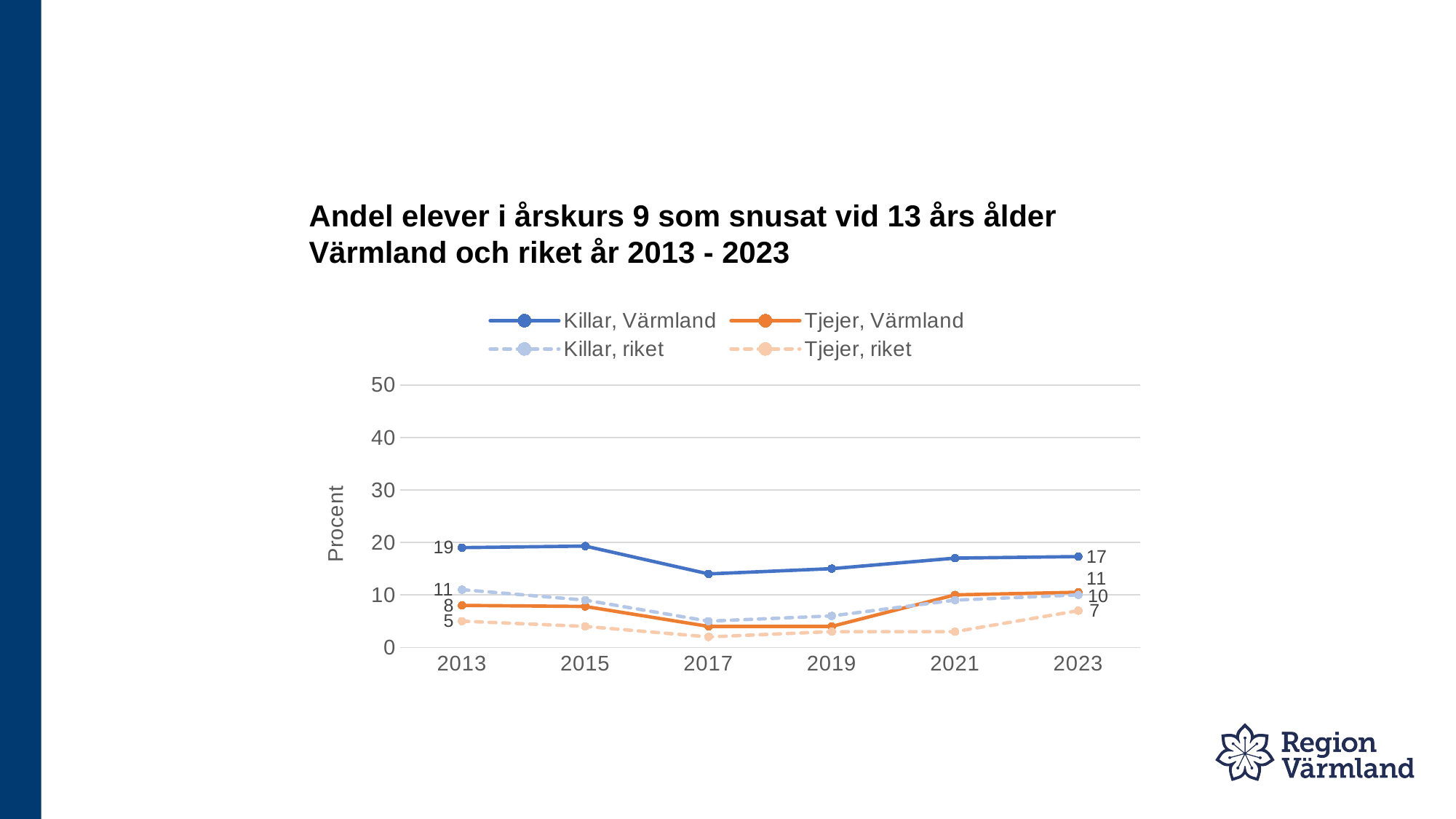
Which series has the highest value in 2013? Killar, Värmland Which series has the lowest value in 2023? Tjejer, riket By how much did the value for Killar, Värmland change from 2013 to 2023? 2 What is the value for Tjejer, riket in 2013? 5 What is the value for Killar, Värmland in 2013? 19 How many series does the legend list? 4 Is the value for Killar, Värmland in 2017 greater or less than 20? less What type of chart is shown on the slide? line chart How many years are shown on the x axis? 6 What is the label on the y axis? Procent What is the value for Tjejer, Värmland in 2023? 11 What is the value for Killar, Värmland in 2023? 17